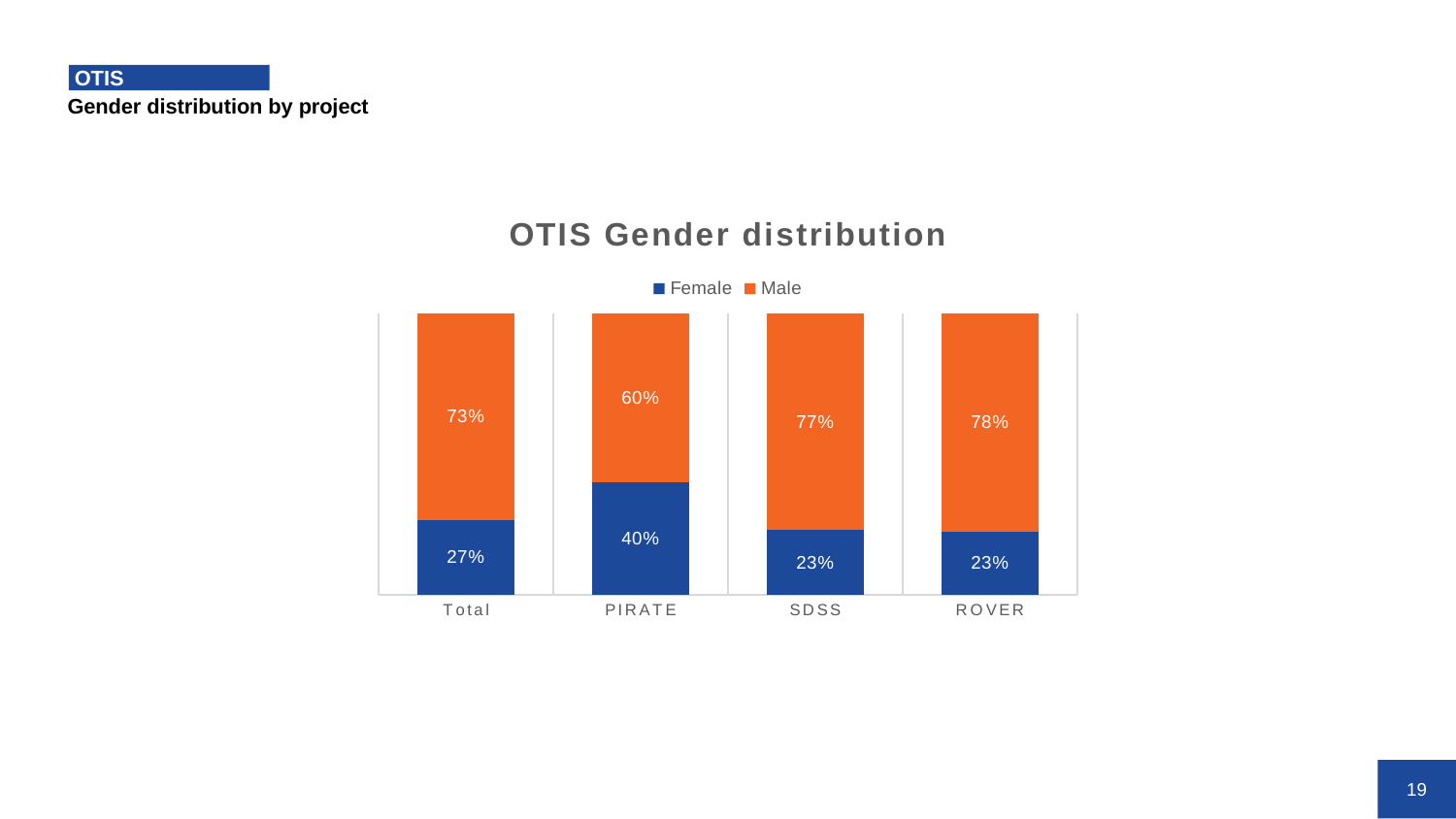
What is the Male share for SDSS? 77% What is the title of the chart? OTIS Gender distribution What is the Male share for ROVER? 78% How many series does the legend list? 2 Which category has the lowest Male share? PIRATE How many categories are shown on the x axis? 4 What is the difference between the Male and Female shares for PIRATE? 20% Is the Female share larger for Total or for SDSS? Total What kind of chart is shown? Stacked bar chart What is the Female share for PIRATE? 40% What is the Female share for Total? 27% Which project has the highest Female share? PIRATE